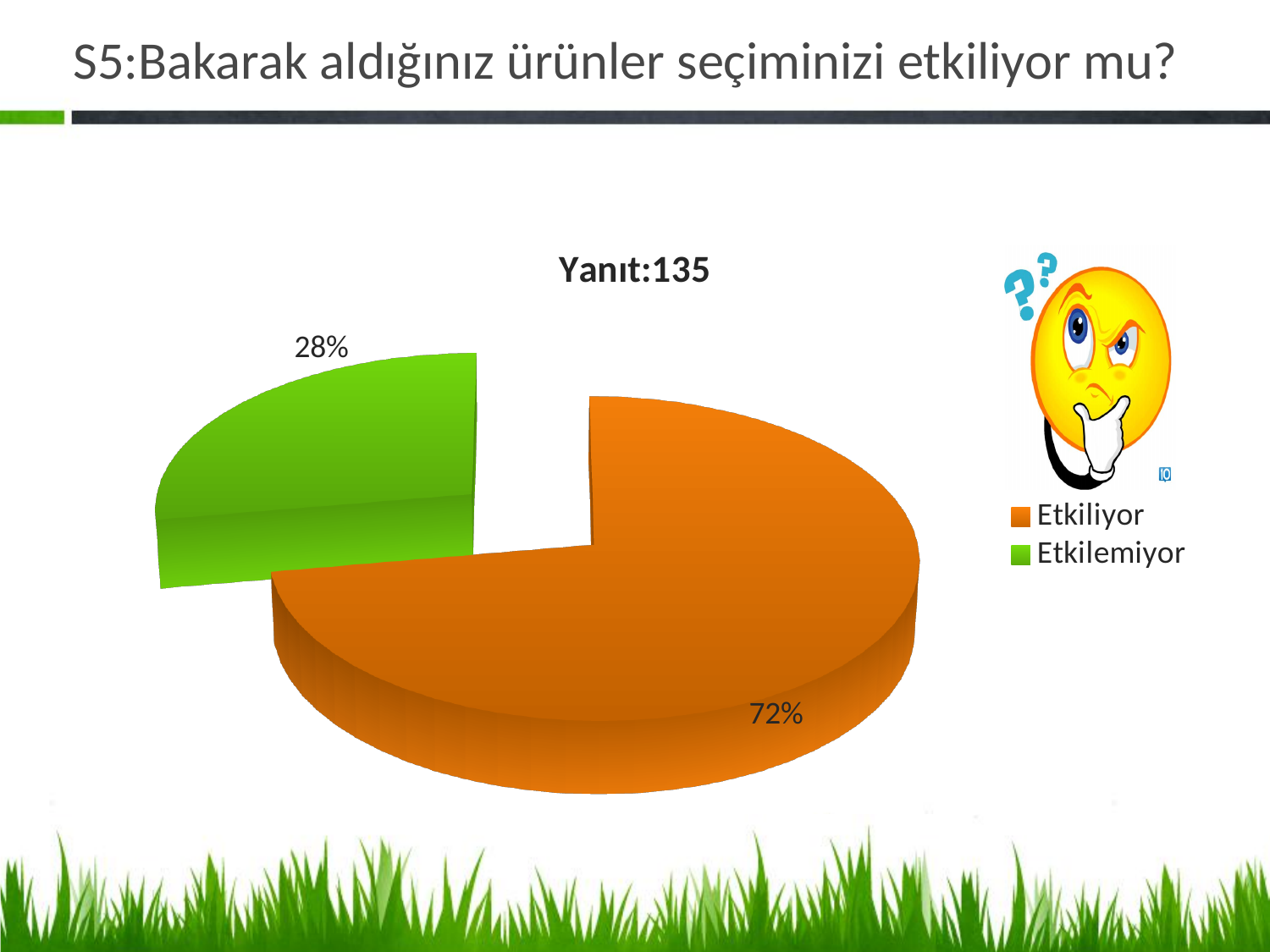
What is the chart's title? Yanıt:135 How many slices does the pie chart have? 2 What share of the pie does Etkilemiyor take? 28% How many entries does the legend list? 2 What kind of chart is shown on the slide? pie chart Which slice is the smallest? Etkilemiyor What share of the pie does Etkiliyor take? 72% Which slice is the largest? Etkiliyor What is the difference in percentage points between Etkiliyor and Etkilemiyor? 44 What colour is the Etkilemiyor slice? green Which is larger, Etkiliyor or Etkilemiyor? Etkiliyor